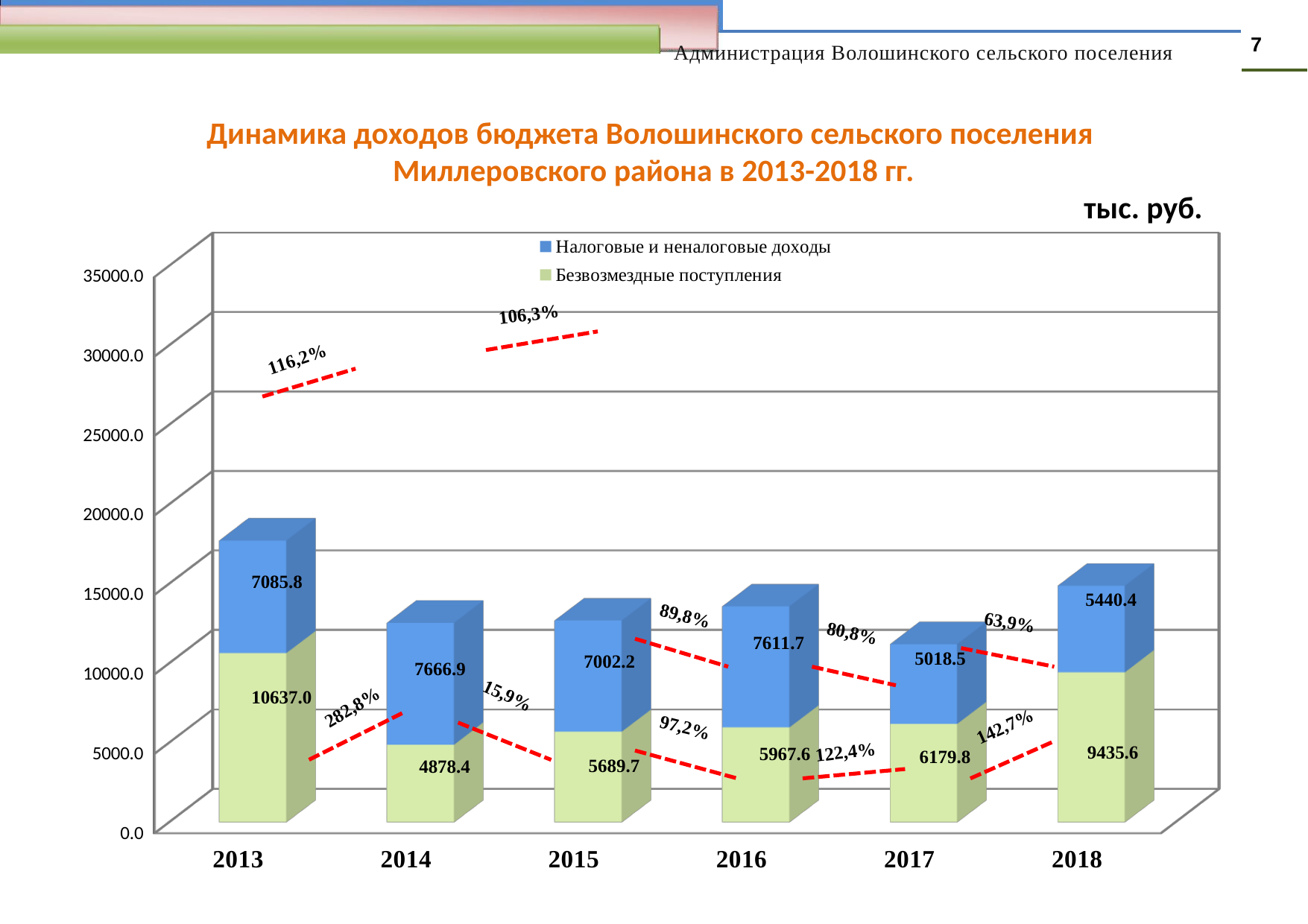
What type of chart is shown on the slide? bar chart What is the difference between Безвозмездные поступления in 2018 and in 2017? 3255.8 What is the total of the stacked bar for 2017? 11198.3 What is the value of Безвозмездные поступления for 2018? 9435.6 How many years are shown on the x axis? 6 How many series does the legend list? 2 Which is larger in 2016: Налоговые и неналоговые доходы or Безвозмездные поступления? Налоговые и неналоговые доходы What is the value of Налоговые и неналоговые доходы for 2014? 7666.9 What unit is indicated above the chart? тыс. руб. What is the value of Безвозмездные поступления for 2013? 10637.0 In which year is Безвозмездные поступления the highest? 2013 In which year is Налоговые и неналоговые доходы the lowest? 2017